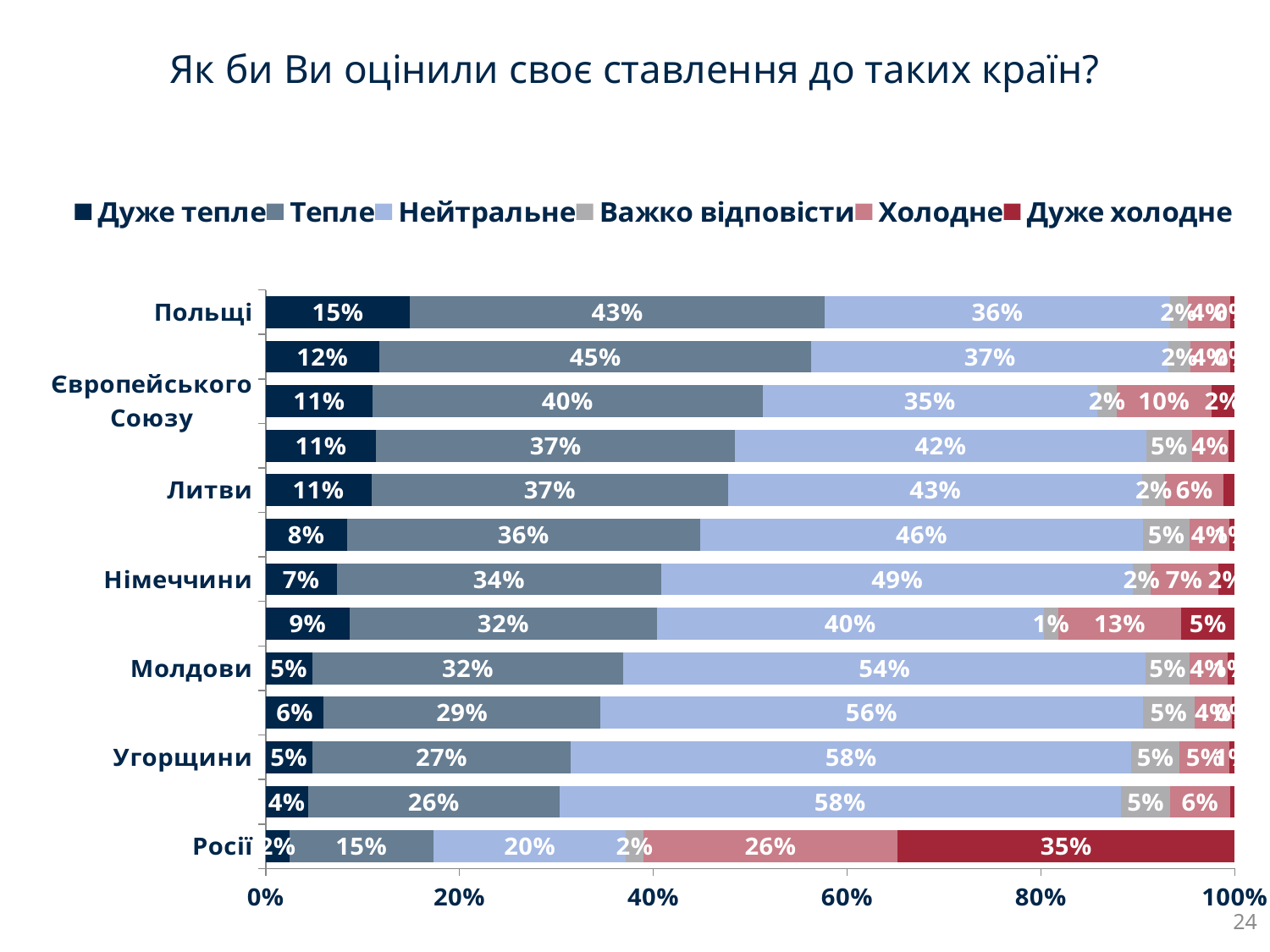
What is the 'Холодне' value for Європейського Союзу? 10% Which country has the highest 'Дуже тепле' share? Польщі Which has a larger 'Тепле' share, Польщі or Росії? Польщі How many series does the legend list? 6 Which country has the highest 'Дуже холодне' share? Росії What percentage of respondents have a 'Дуже тепле' attitude toward Польщі? 15% What is the difference between the 'Нейтральне' values for Молдови and Німеччини? 5 percentage points What share of respondents have a 'Дуже холодне' attitude toward Росії? 35% What is the 'Тепле' value for Польщі? 43% What is the 'Нейтральне' value for Литви? 43% What is the 'Нейтральне' value for Угорщини? 58% What type of chart is shown on the slide? Stacked bar chart